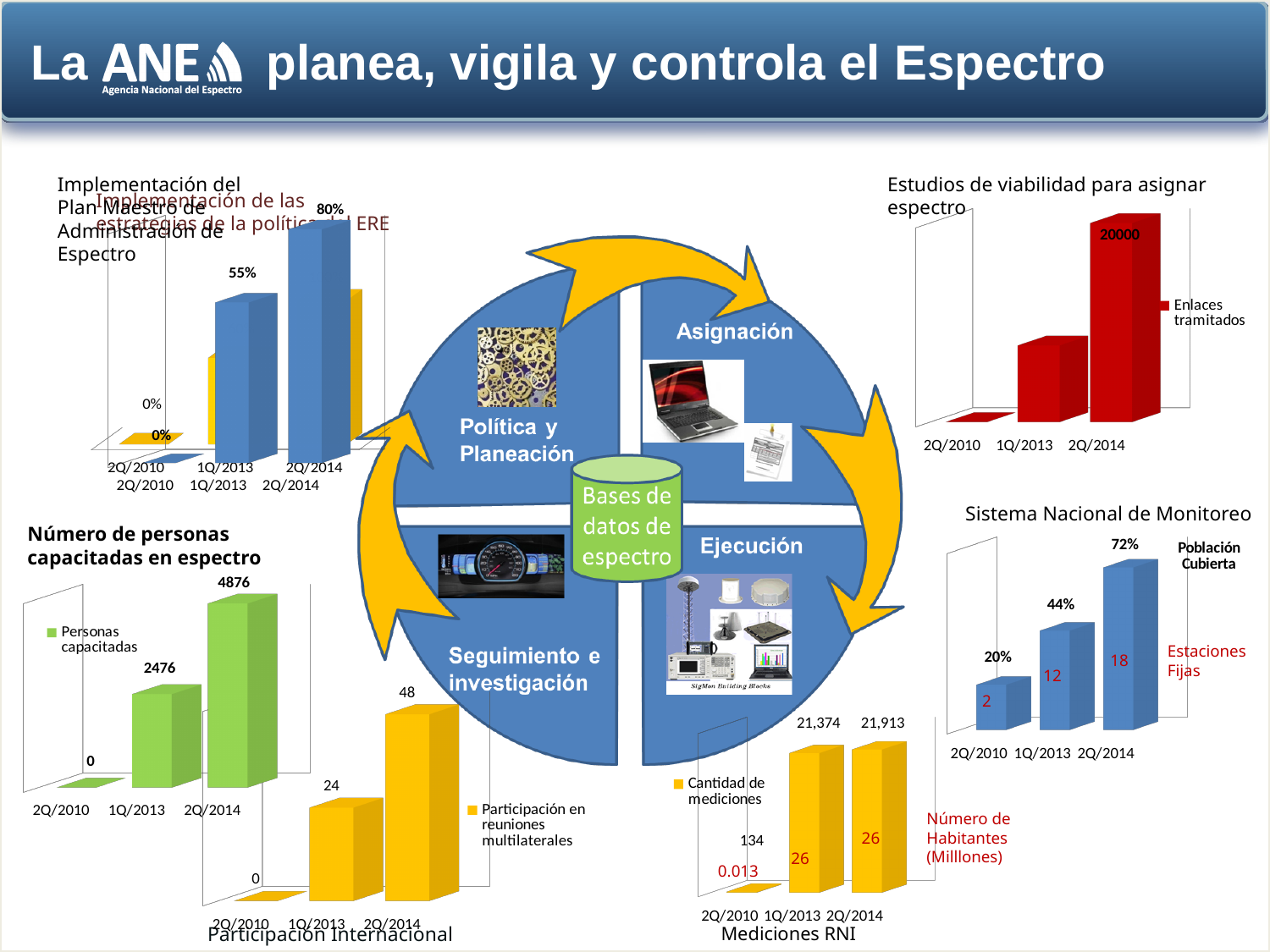
In the 'Estudios de viabilidad para asignar espectro' chart, what series does the legend list? Enlaces tramitados In the 'Implementación del Plan Maestro de Administración de Espectro' chart, what is the value for 1Q/2013? 55% In the 'Participación Internacional' chart, what is the value for 2Q/2014? 48 In the 'Número de personas capacitadas en espectro' chart, what is the difference between the 2Q/2014 and 1Q/2013 values? 2400 In the 'Número de personas capacitadas en espectro' chart, what is the value for 2Q/2014? 4876 In the 'Número de personas capacitadas en espectro' chart, what is the value for 1Q/2013? 2476 In the 'Sistema Nacional de Monitoreo' chart, what is the Población Cubierta value for 2Q/2014? 72% In the 'Participación Internacional' chart, what is the value for 1Q/2013? 24 In the 'Número de personas capacitadas en espectro' chart, which period has the highest value? 2Q/2014 In the 'Sistema Nacional de Monitoreo' chart, how many Estaciones Fijas are shown for 1Q/2013? 12 In the 'Estudios de viabilidad para asignar espectro' chart, what is the value for 2Q/2014? 20000 In the 'Participación Internacional' chart, do the values rise or fall from 2Q/2010 to 2Q/2014? rise